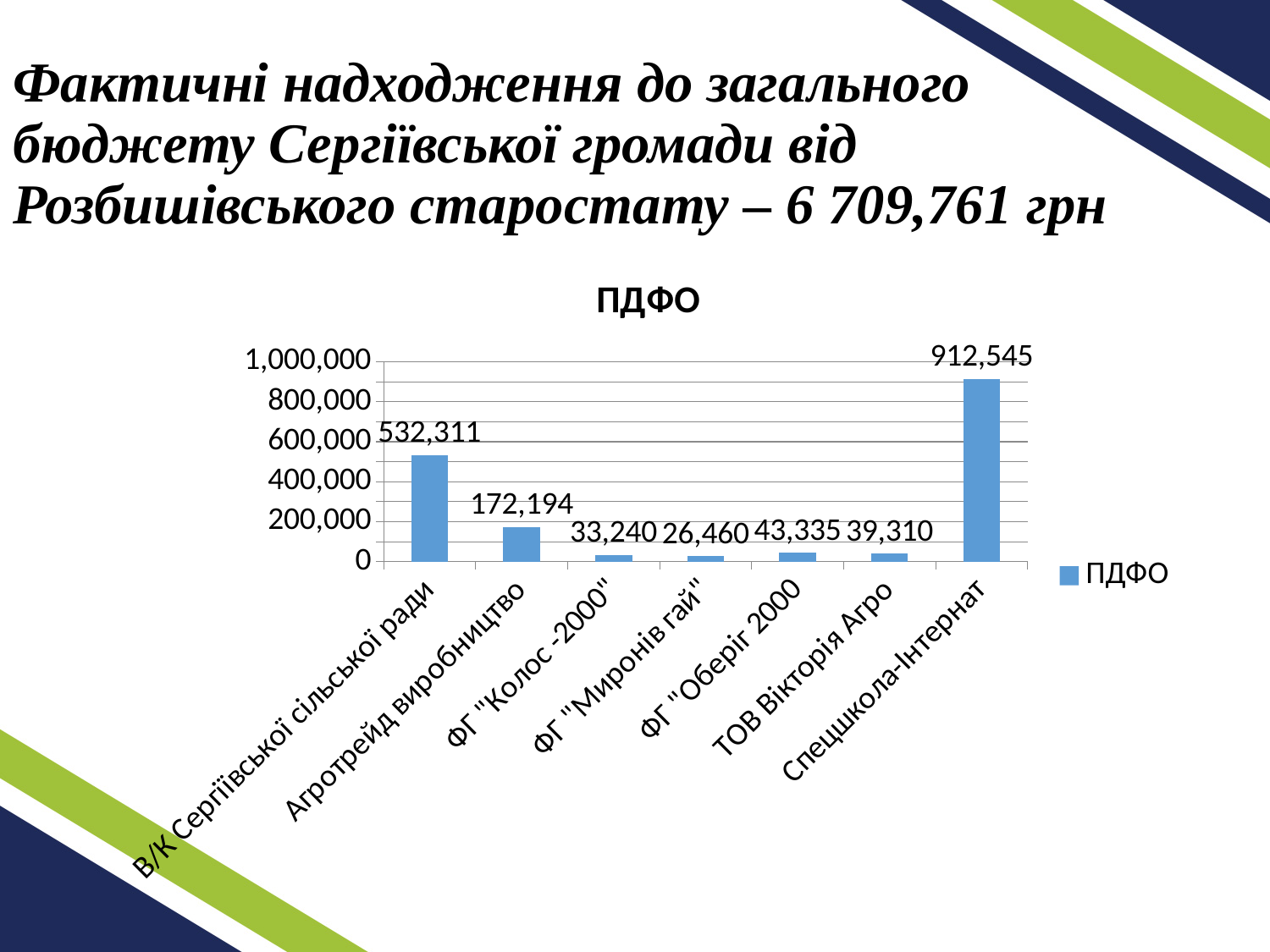
What is the difference between the ПДФО values for Спецшкола-Інтернат and В/К Сергіївської сільської ради? 380,234 Is the ПДФО value for В/К Сергіївської сільської ради greater or less than 400,000? greater What is the ПДФО value for ФГ "Миронів гай"? 26,460 How many series does the chart legend list? 1 What type of chart is shown on the slide? bar chart Which category has the highest ПДФО value? Спецшкола-Інтернат What is the ПДФО value for Агротрейд виробництво? 172,194 What is the ПДФО value for Спецшкола-Інтернат? 912,545 What is the difference between the ПДФО values for ФГ "Оберіг 2000" and ТОВ Вікторія Агро? 4,025 Which category has the lowest ПДФО value? ФГ "Миронів гай" Which has a larger ПДФО value, ФГ "Колос -2000" or ФГ "Оберіг 2000"? ФГ "Оберіг 2000" How many categories are shown on the x axis of the chart? 7